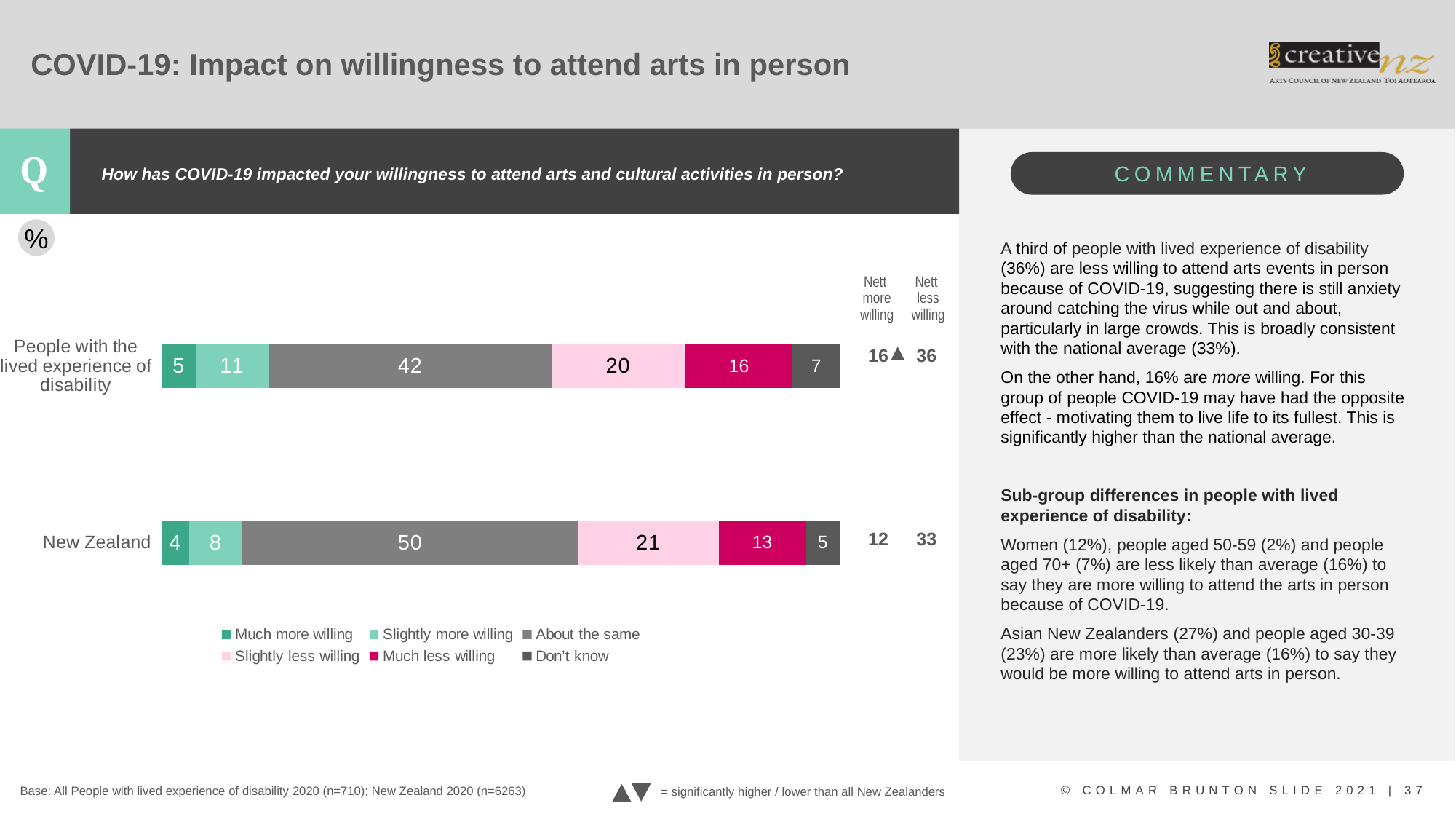
Which response category has the lowest value for people with the lived experience of disability? Much more willing What kind of chart is shown on the slide? Stacked bar chart Which response category has the highest value for New Zealand? About the same What is the 'Slightly less willing' value for New Zealand? 21 What is the 'Much more willing' value for people with the lived experience of disability? 5 How many series does the legend list? 6 Which group has the larger 'Much less willing' value, people with the lived experience of disability or New Zealand? People with the lived experience of disability What percentage of people with the lived experience of disability said they are about the same in willingness to attend arts in person? 42 What is the Nett more willing figure for New Zealand? 12 What percentage of New Zealand respondents said they are much less willing to attend arts in person? 13 What is the Nett less willing figure for people with the lived experience of disability? 36 What is the difference between the 'About the same' values for New Zealand and people with the lived experience of disability? 8